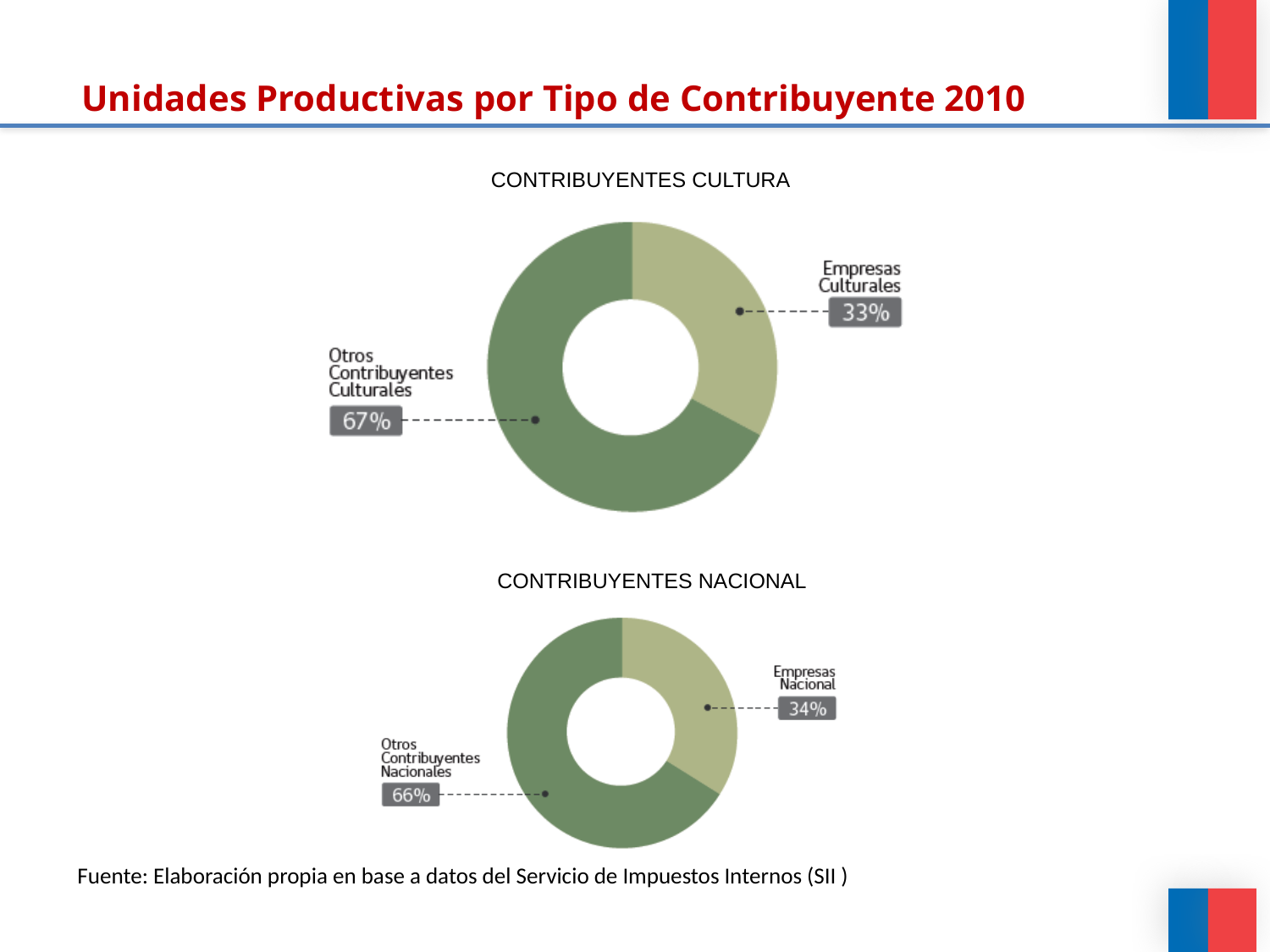
In the CONTRIBUYENTES NACIONAL chart, what is the difference between the shares of Otros Contribuyentes Nacionales and Empresas Nacional? 32% What kind of chart is the CONTRIBUYENTES NACIONAL chart? Pie chart (donut) In the CONTRIBUYENTES CULTURA chart, what share is labelled for Otros Contribuyentes Culturales? 67% Which is larger: the share of Empresas Culturales in the CONTRIBUYENTES CULTURA chart or the share of Empresas Nacional in the CONTRIBUYENTES NACIONAL chart? Empresas Nacional How many categories does the CONTRIBUYENTES CULTURA chart show? 2 In the CONTRIBUYENTES CULTURA chart, what is the difference between the shares of Otros Contribuyentes Culturales and Empresas Culturales? 34% In the CONTRIBUYENTES NACIONAL chart, what share is labelled for Empresas Nacional? 34% How many charts are shown on the slide? 2 In the CONTRIBUYENTES CULTURA chart, which category has the largest share? Otros Contribuyentes Culturales In the CONTRIBUYENTES NACIONAL chart, what share is labelled for Otros Contribuyentes Nacionales? 66% In the CONTRIBUYENTES CULTURA chart, what share is labelled for Empresas Culturales? 33% In the CONTRIBUYENTES NACIONAL chart, which category has the smallest share? Empresas Nacional